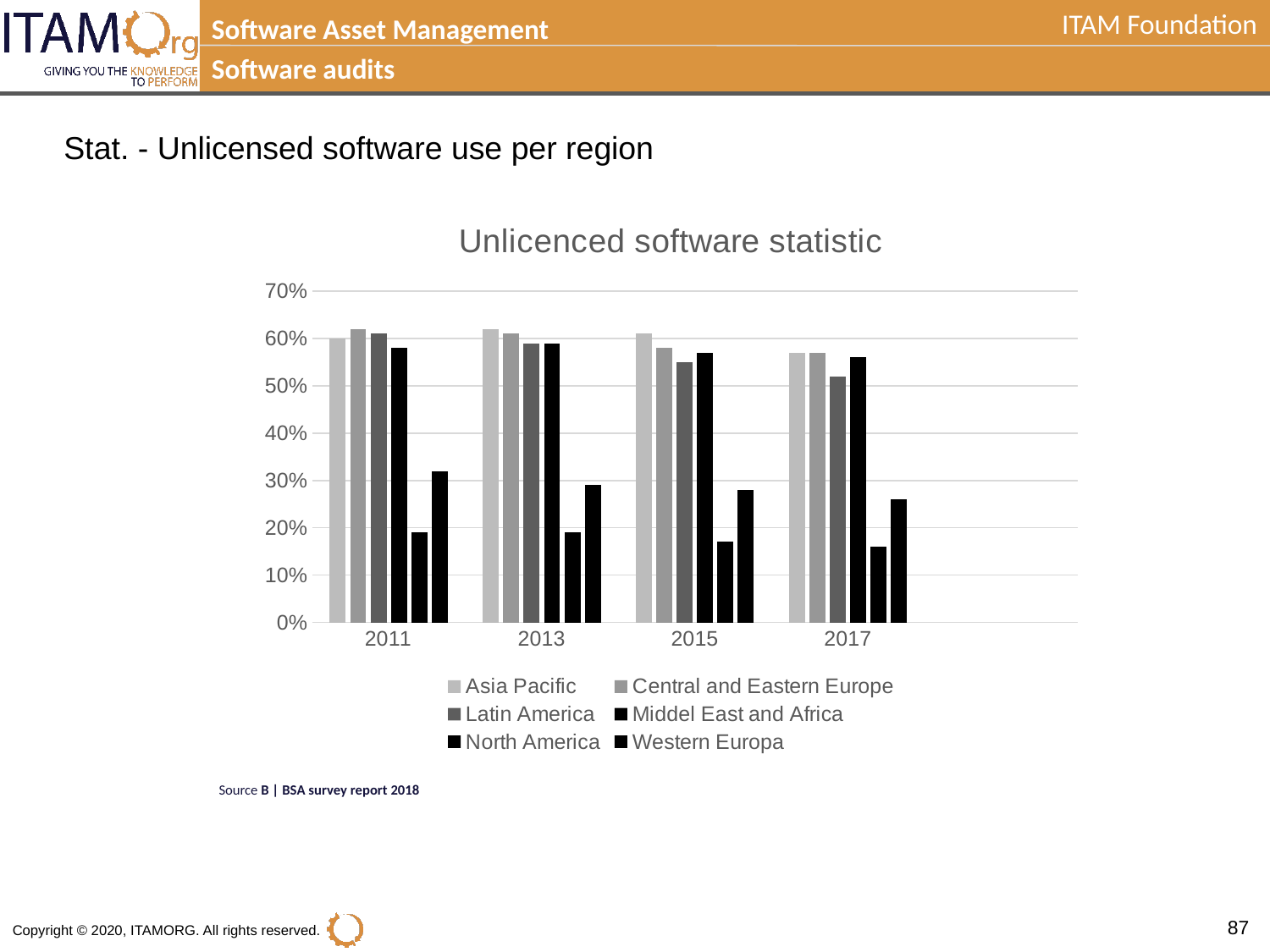
What is the title of the chart? Unlicenced software statistic Do the values for Western Europa rise or fall from 2011 to 2017? fall Is the value for Western Europa in 2017 greater or less than 20%? greater In 2017, which is larger: Asia Pacific or Latin America? Asia Pacific Which region has the lowest value in 2015? North America Is the value for Asia Pacific in 2013 greater or less than 50%? greater Is the value for Western Europa in 2011 greater or less than 30%? greater What kind of chart is shown on the slide? bar chart How many years are shown on the x axis of the chart? 4 How many series does the chart legend list? 6